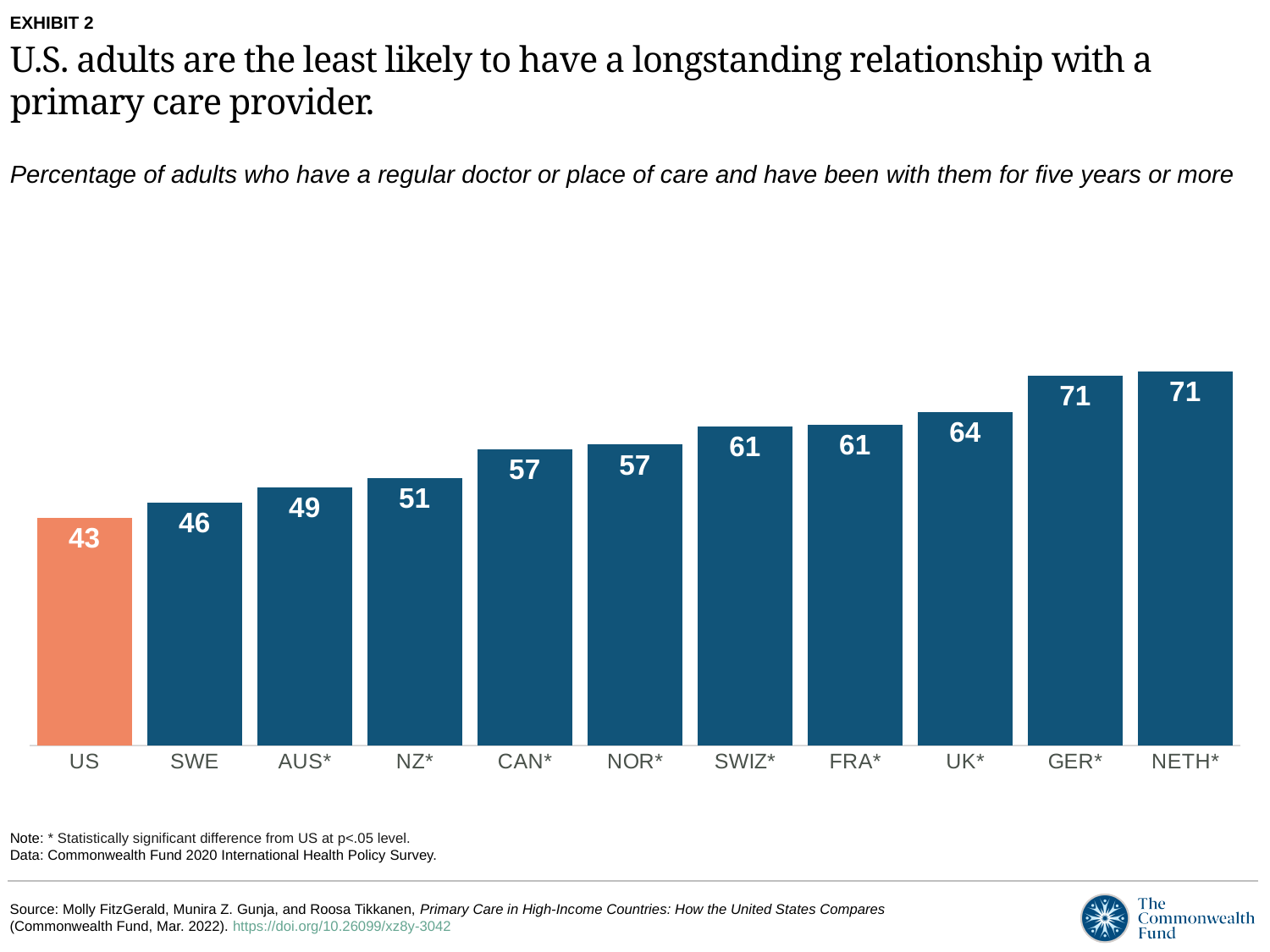
What kind of chart is shown on the slide? bar chart What is the value for US? 43 Which is larger, the value for NZ* or the value for SWE? NZ* Do the values rise or fall from left to right along the x axis? rise How many categories are shown on the chart? 11 What is the value for UK*? 64 What is the difference between the values for NETH* and US? 28 Which bar is shown in a different colour (orange) from the others? US What is the difference between the values for UK* and SWE? 18 Which is larger, the value for AUS* or the value for SWIZ*? SWIZ* Which category has the lowest value? US What is the value for CAN*? 57